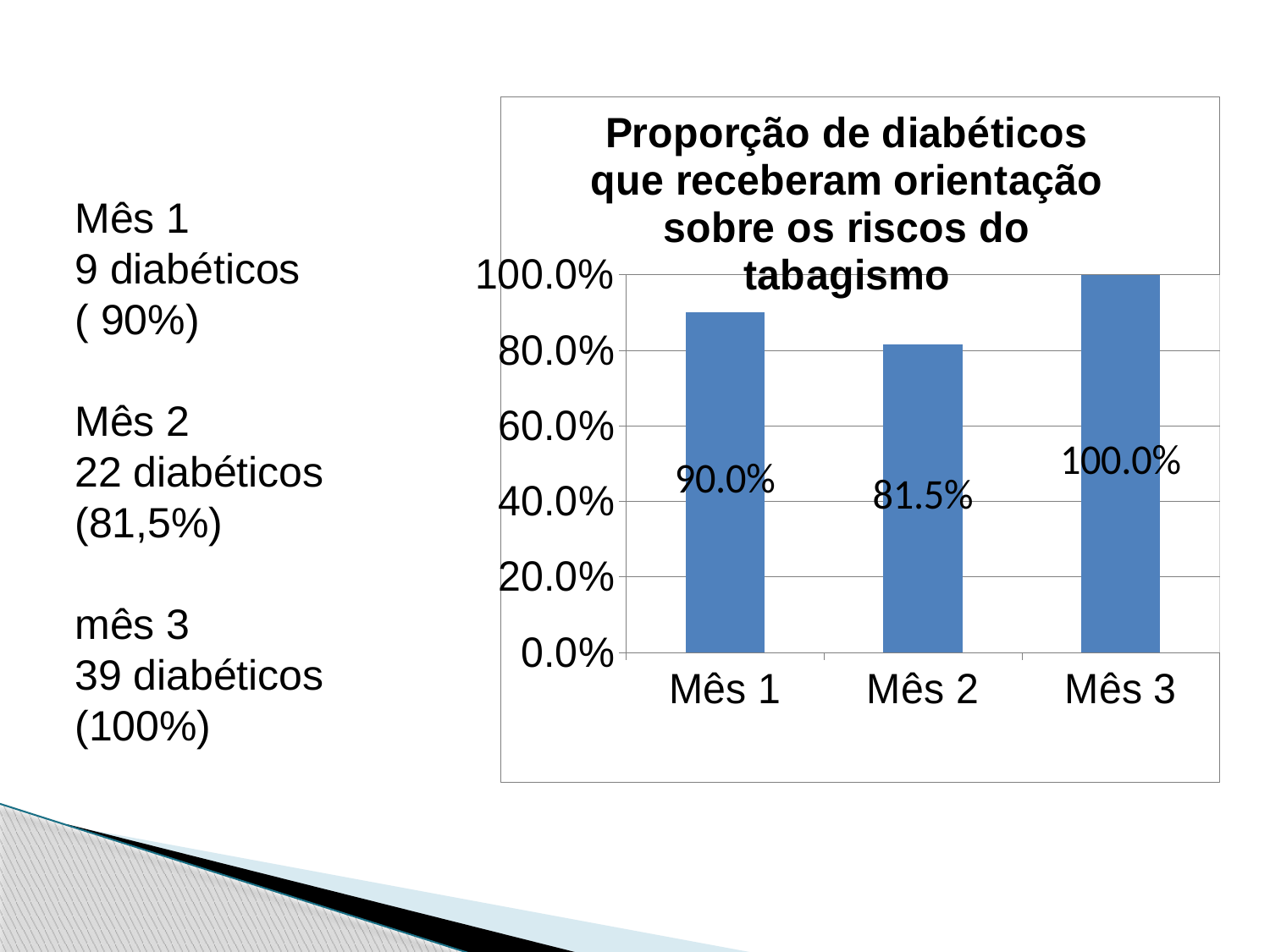
How many categories are shown on the x axis? 3 What is the difference between the values for Mês 1 and Mês 2? 8.5% What is the value for Mês 2? 81.5% Which month has the lowest value? Mês 2 Which is larger, the value for Mês 1 or the value for Mês 2? Mês 1 Is the value for Mês 2 greater or less than 60.0%? greater What is the title of the chart? Proporção de diabéticos que receberam orientação sobre os riscos do tabagismo What is the value for Mês 1? 90.0% Which month has the highest value? Mês 3 What is the difference between the values for Mês 3 and Mês 2? 18.5% What is the value for Mês 3? 100.0% What kind of chart is shown on the slide? bar chart